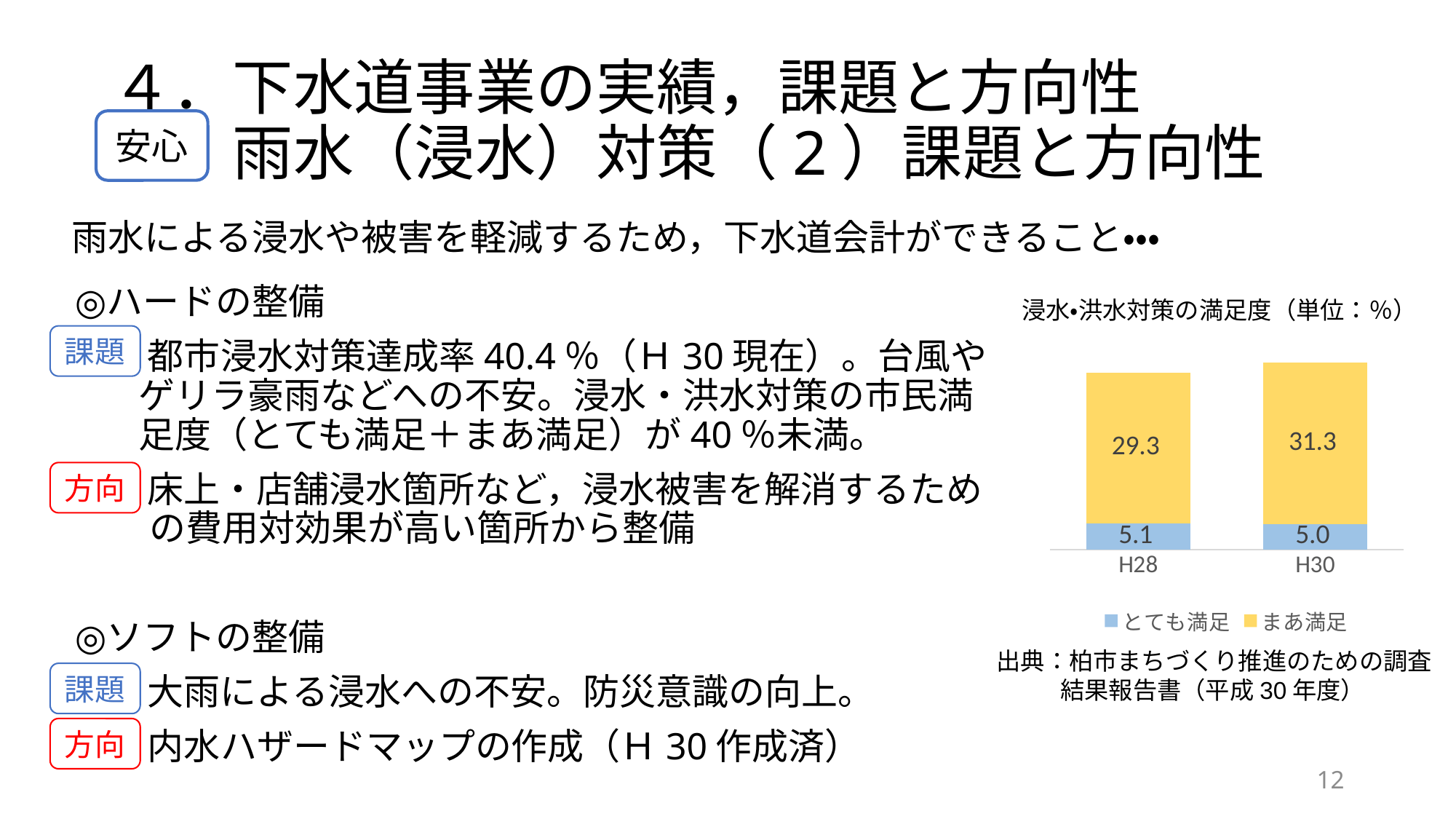
What is the value for とても満足 in H30? 5.0 What is the total of the stacked bar for H30? 36.3 What is the value for まあ満足 in H30? 31.3 What is the value for まあ満足 in H28? 29.3 How many series does the chart legend list? 2 What kind of chart is shown on the slide? Stacked bar chart Which year has the higher value for まあ満足, H28 or H30? H30 What is the difference between the まあ満足 values for H30 and H28? 2.0 What is the value for とても満足 in H28? 5.1 How many categories are shown on the x axis of the chart? 2 What is the title of the chart? 浸水•洪水対策の満足度（単位：%） What is the total of the stacked bar for H28? 34.4